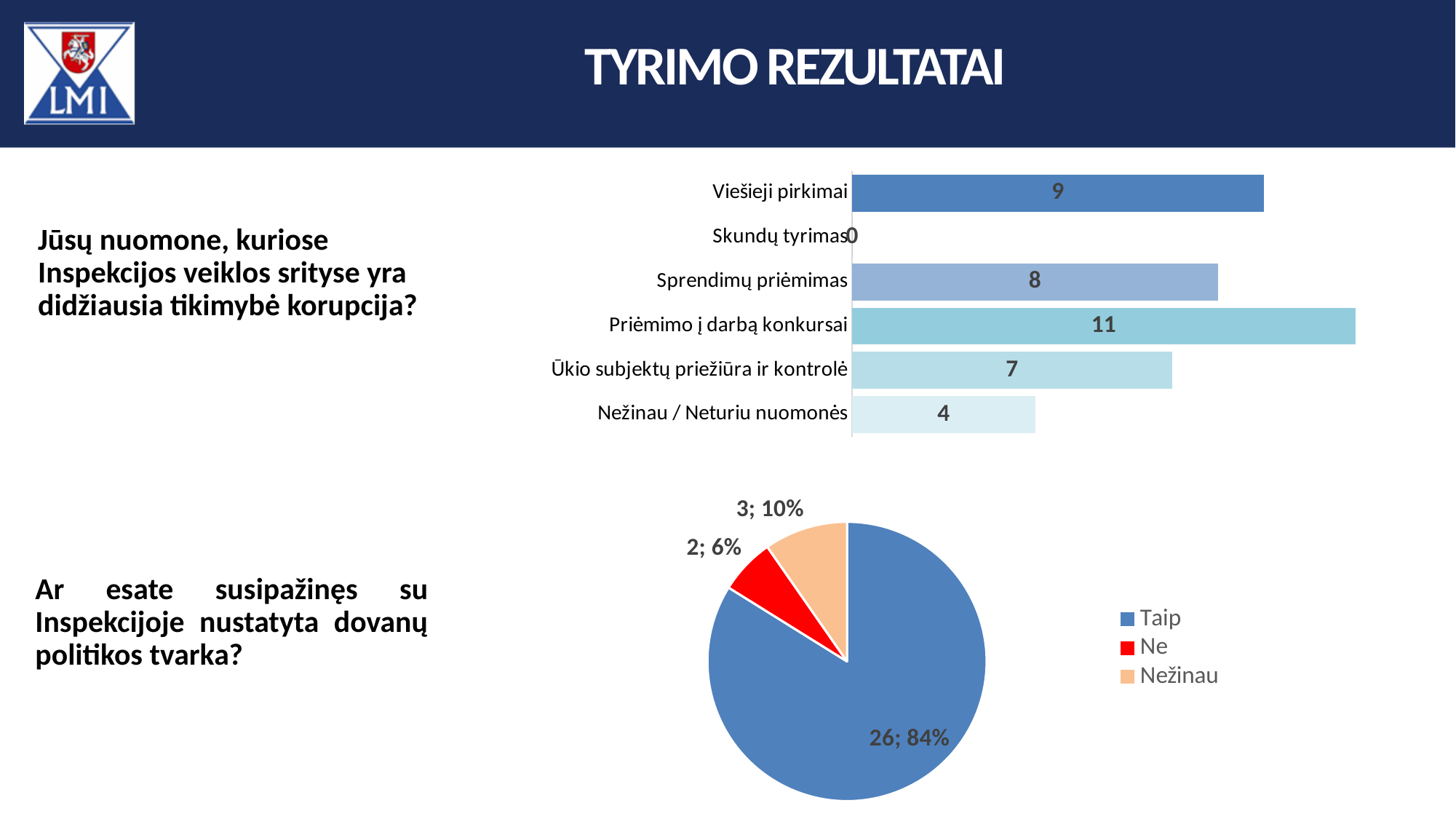
In the bottom pie chart, what is the value for Ne? 2 In the top bar chart, what is the value for Priėmimo į darbą konkursai? 11 What kind of chart is the top chart on the slide? Bar chart In the top bar chart, which category has the highest value? Priėmimo į darbą konkursai In the top bar chart, which is larger: Viešieji pirkimai or Nežinau / Neturiu nuomonės? Viešieji pirkimai In the bottom pie chart, what share does the Taip slice have? 84% In the top bar chart, what is the value for Ūkio subjektų priežiūra ir kontrolė? 7 How many entries does the legend of the bottom pie chart list? 3 In the bottom pie chart, what colour is the Nežinau slice? Light orange In the top bar chart, which category has the lowest value? Skundų tyrimas How many categories does the top bar chart show? 6 In the top bar chart, what is the difference between Viešieji pirkimai and Sprendimų priėmimas? 1